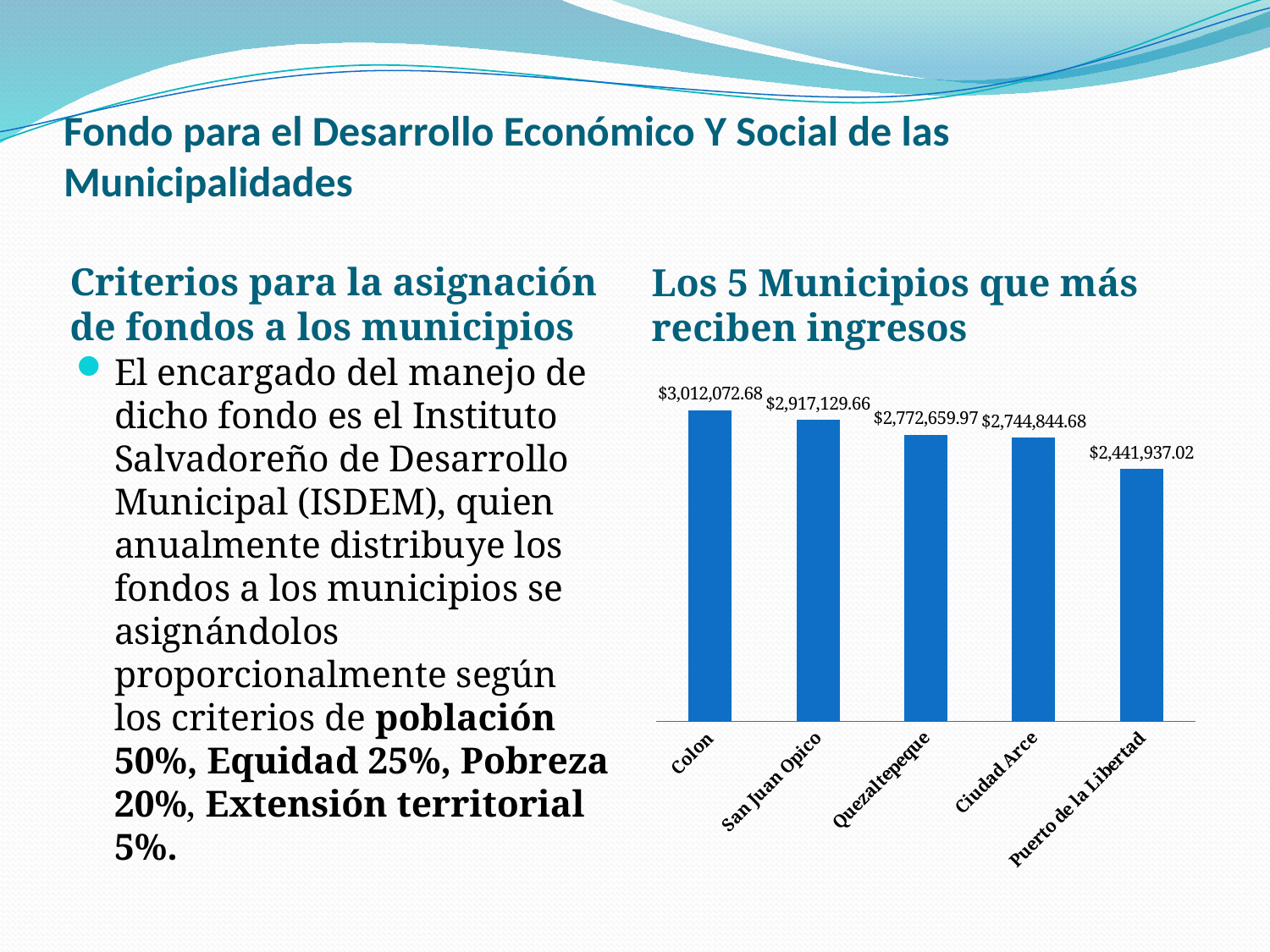
Which municipality has the lowest value in the chart? Puerto de la Libertad What is the value shown for Quezaltepeque? $2,772,659.97 What is the value shown for San Juan Opico? $2,917,129.66 What is the difference between the values for Colon and San Juan Opico? $94,943.02 How many municipalities are shown in the chart? 5 Which is larger, the value for Quezaltepeque or the value for Ciudad Arce? Quezaltepeque Do the values rise or fall from left to right across the chart? Fall Which municipality has the highest value in the chart? Colon What is the value shown for Puerto de la Libertad? $2,441,937.02 What is the difference between the values for Colon and Puerto de la Libertad? $570,135.66 What is the value shown for Colon? $3,012,072.68 What kind of chart is shown on the slide? Bar chart